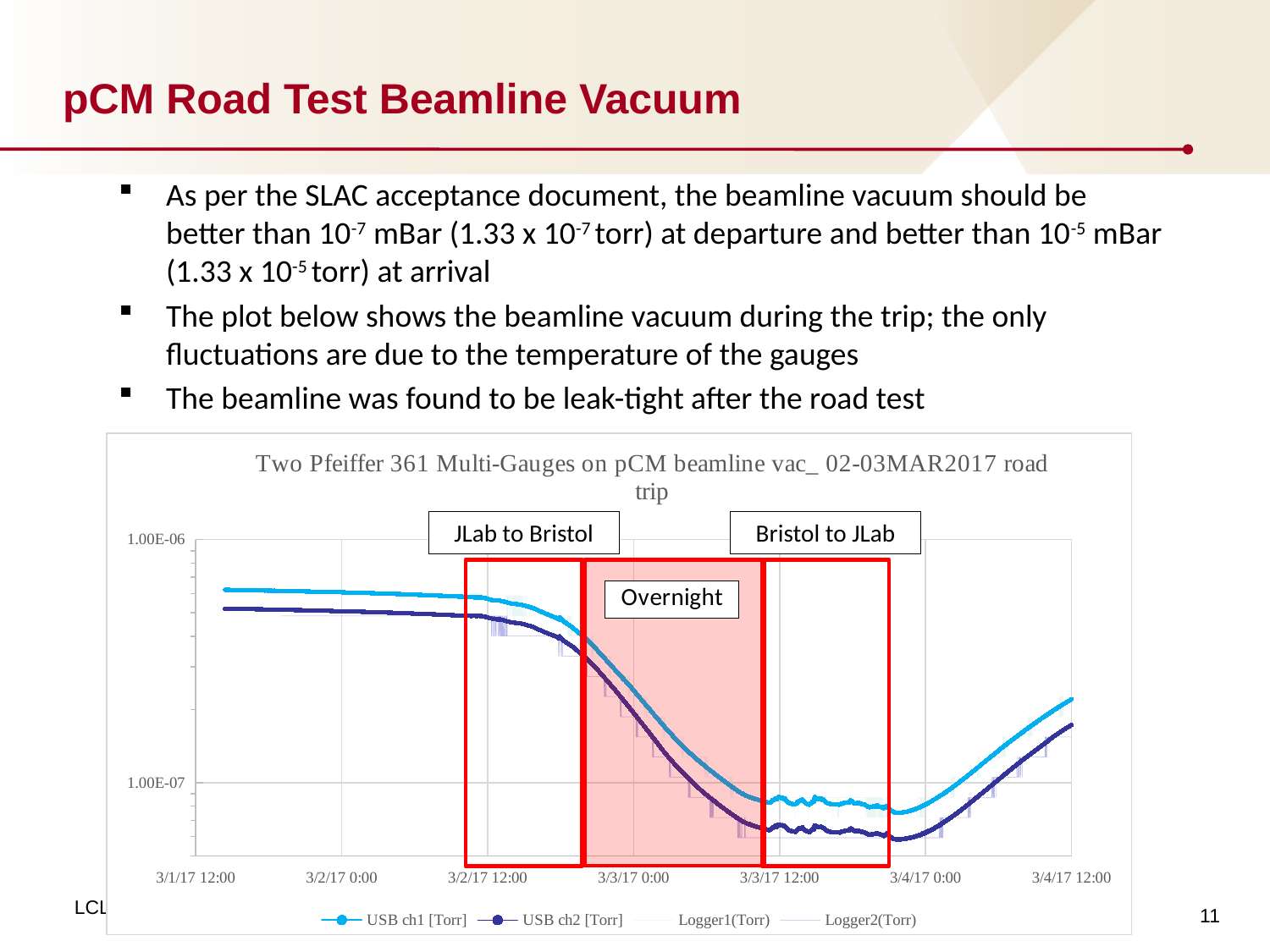
Do the USB ch1 [Torr] values rise or fall between 3/2/17 12:00 and 3/3/17 12:00? fall What label is shown in the shaded region between the 'JLab to Bristol' and 'Bristol to JLab' boxes? Overnight How many date/time tick labels are shown on the x axis? 7 Is the value of USB ch2 [Torr] at 3/2/17 12:00 greater or less than 1.00E-07? greater Do the USB ch2 [Torr] values rise or fall between 3/4/17 0:00 and 3/4/17 12:00? rise What is the title of the chart? Two Pfeiffer 361 Multi-Gauges on pCM beamline vac_ 02-03MAR2017 road trip Which series is higher at 3/3/17 0:00, USB ch1 [Torr] or USB ch2 [Torr]? USB ch1 [Torr] How many series does the chart legend list? 4 Is the value of USB ch2 [Torr] at 3/3/17 12:00 greater or less than 1.00E-07? less Is the value of USB ch1 [Torr] at 3/4/17 12:00 greater or less than 1.00E-07? greater What kind of chart is shown on the slide? line chart